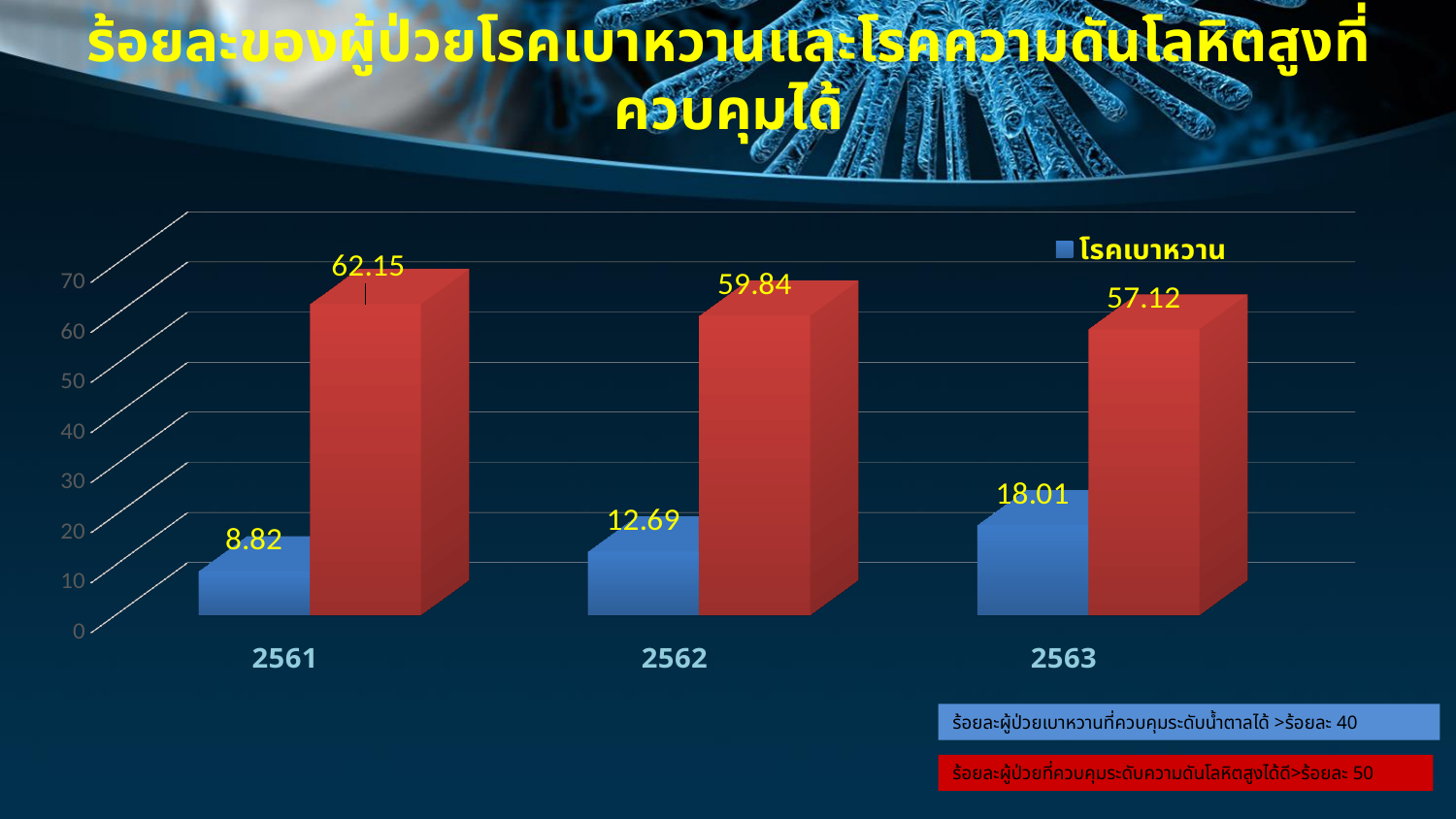
How many years are shown on the x axis? 3 Which series name is shown in the chart legend? โรคเบาหวาน In which year is the blue (โรคเบาหวาน) bar highest? 2563 What is the difference between the red bar and the blue bar for 2562? 47.15 Do the values of the blue (โรคเบาหวาน) bars rise or fall from 2561 to 2563? Rise In which year is the red bar lowest? 2563 Which is larger: the blue bar for 2562 or the blue bar for 2563? 2563 What is the value of the red bar for 2561? 62.15 What is the value of the blue (โรคเบาหวาน) bar for 2561? 8.82 What is the value of the red bar for 2562? 59.84 What is the value of the blue (โรคเบาหวาน) bar for 2563? 18.01 What kind of chart is shown on the slide? Bar chart